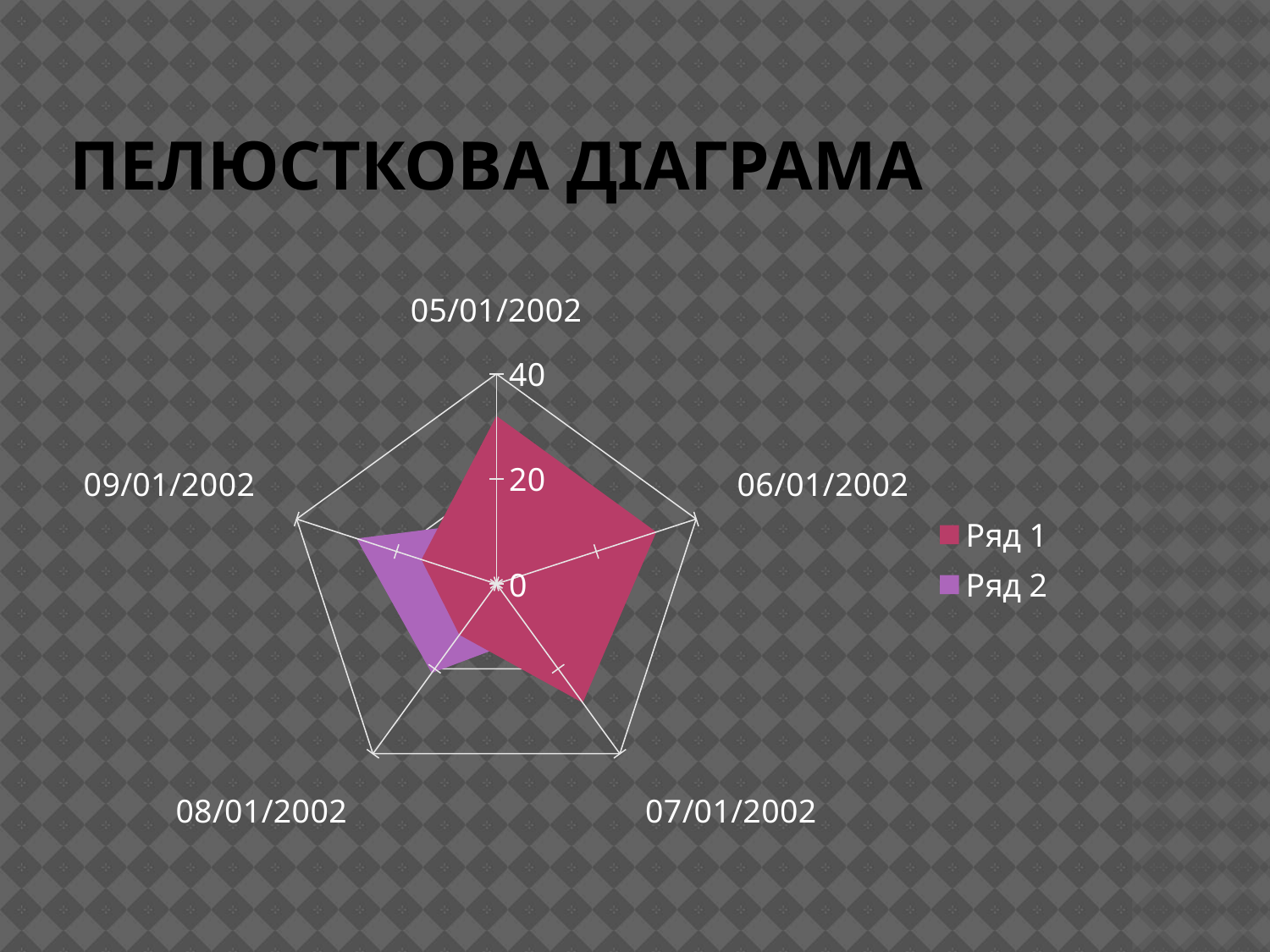
Is the value of Ряд 1 for 07/01/2002 greater or less than 20? greater What is the title of the chart on the slide? ПЕЛЮСТКОВА ДІАГРАМА What kind of chart is shown on the slide? Radar chart How many categories (dates) are plotted on the radar chart? 5 For which date does Ряд 2 have its highest value? 09/01/2002 Is the value of Ряд 2 for 05/01/2002 greater or less than 20? less Is the value of Ряд 2 for 09/01/2002 greater or less than 20? greater For 09/01/2002, which series has the larger value, Ряд 1 or Ряд 2? Ряд 2 How many series does the legend list? 2 What are the names of the two series in the legend? Ряд 1 and Ряд 2